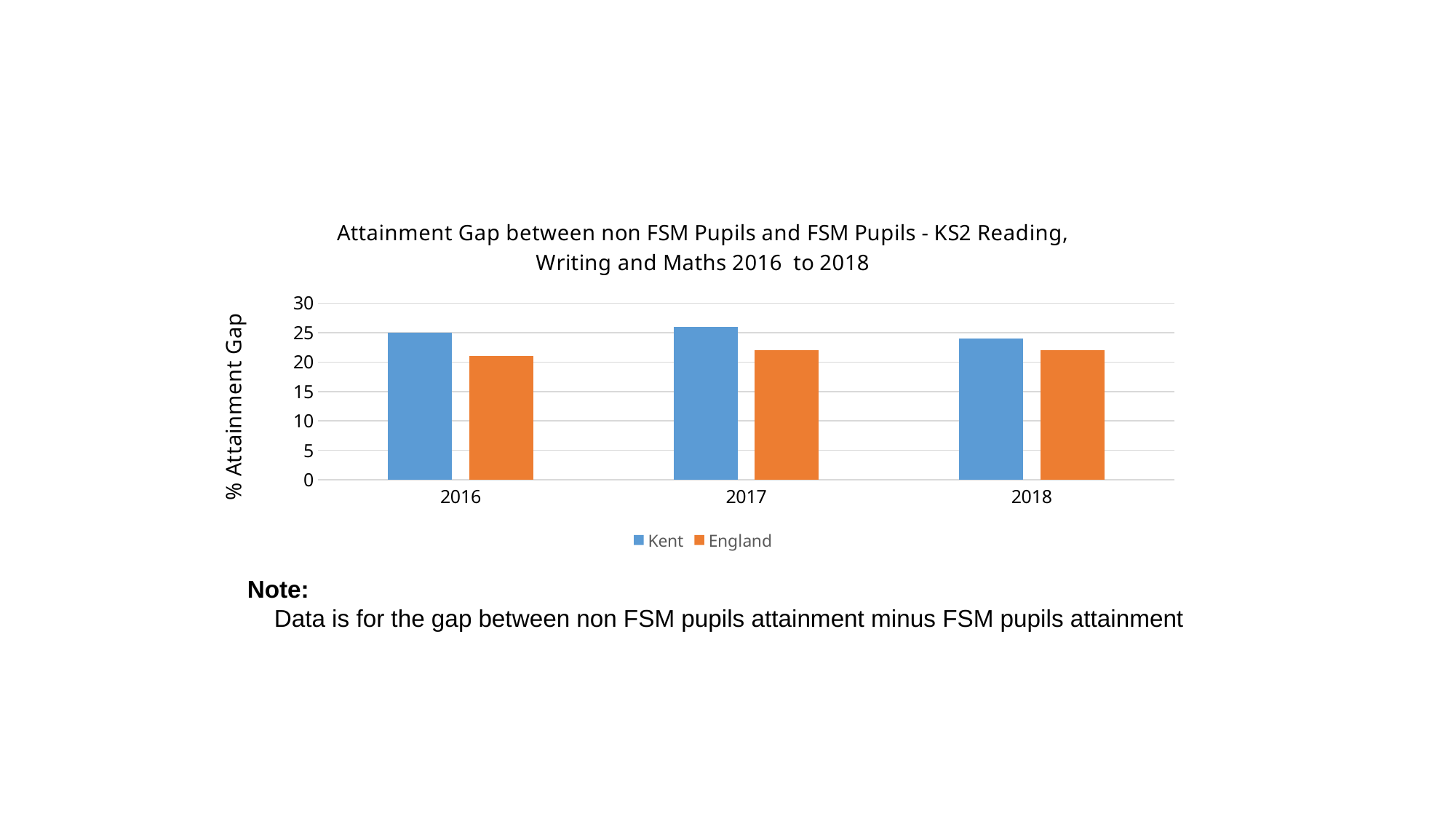
How many series does the legend list? 2 What kind of chart is shown on the slide? bar chart What is the value for Kent in 2016? 25 Is the value for Kent in 2018 greater or less than 25? less What is the label on the vertical axis? % Attainment Gap In 2017, which is larger, the value for Kent or the value for England? Kent How many years are shown on the x axis? 3 In 2016, which is larger, the value for Kent or the value for England? Kent Is the value for England in 2018 greater or less than 20? greater What are the two entries in the legend? Kent and England Is the value for England in 2016 greater or less than 25? less